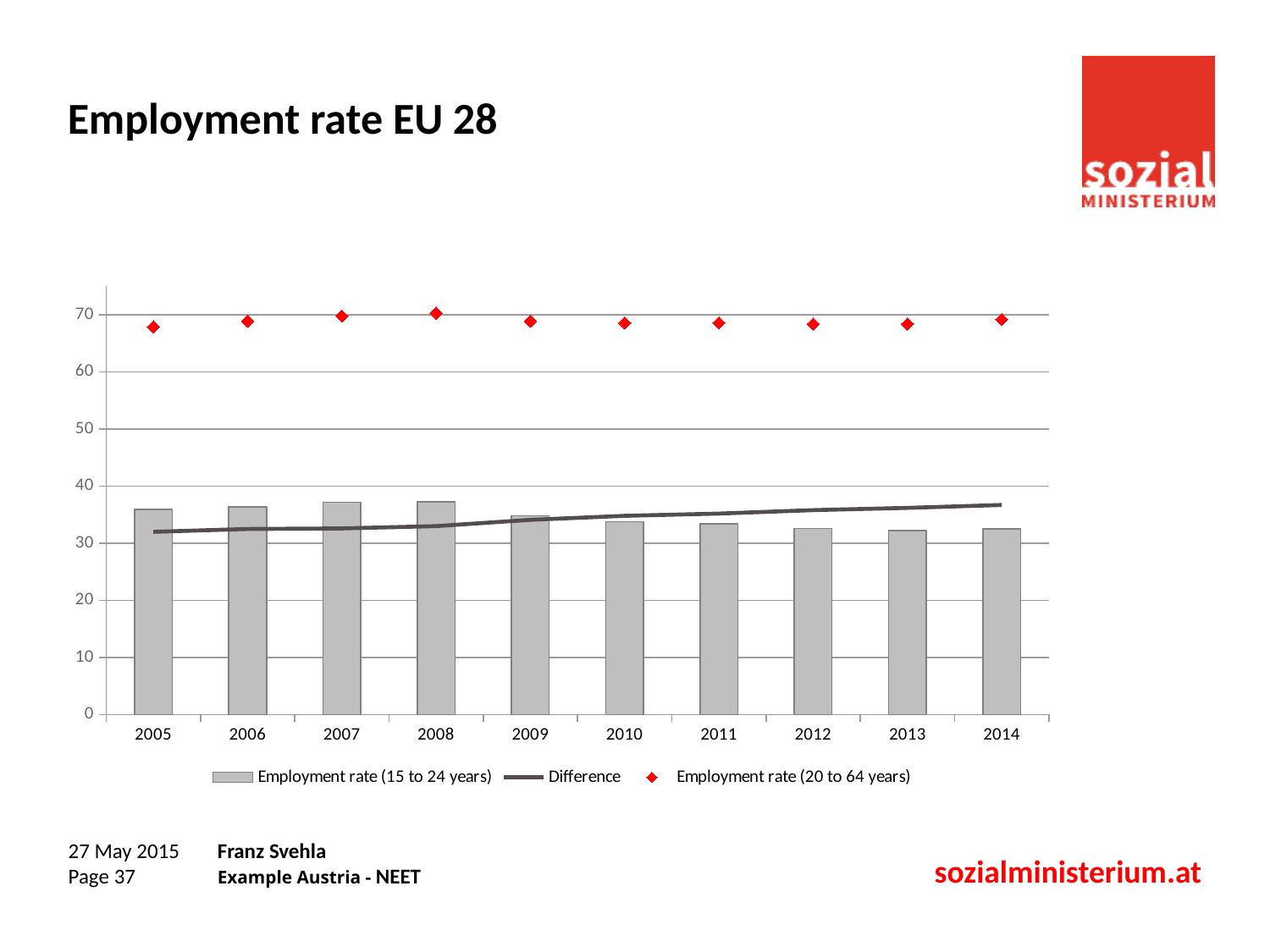
Is the Employment rate (20 to 64 years) value for 2005 greater or less than 70? less Is the value of the Employment rate (15 to 24 years) bar for 2005 greater or less than 30? greater Which series is shown with red diamond markers? Employment rate (20 to 64 years) How many series does the chart legend list? 3 Does the Difference line rise or fall from 2005 to 2014? rise How many years are shown on the x axis of the chart? 10 What kind of chart is shown on the slide? Combined bar and line chart Is the Difference line value for 2014 greater or less than 40? less Do the Employment rate (15 to 24 years) bars rise or fall from 2008 to 2014? fall What is the title of the chart on the slide? Employment rate EU 28